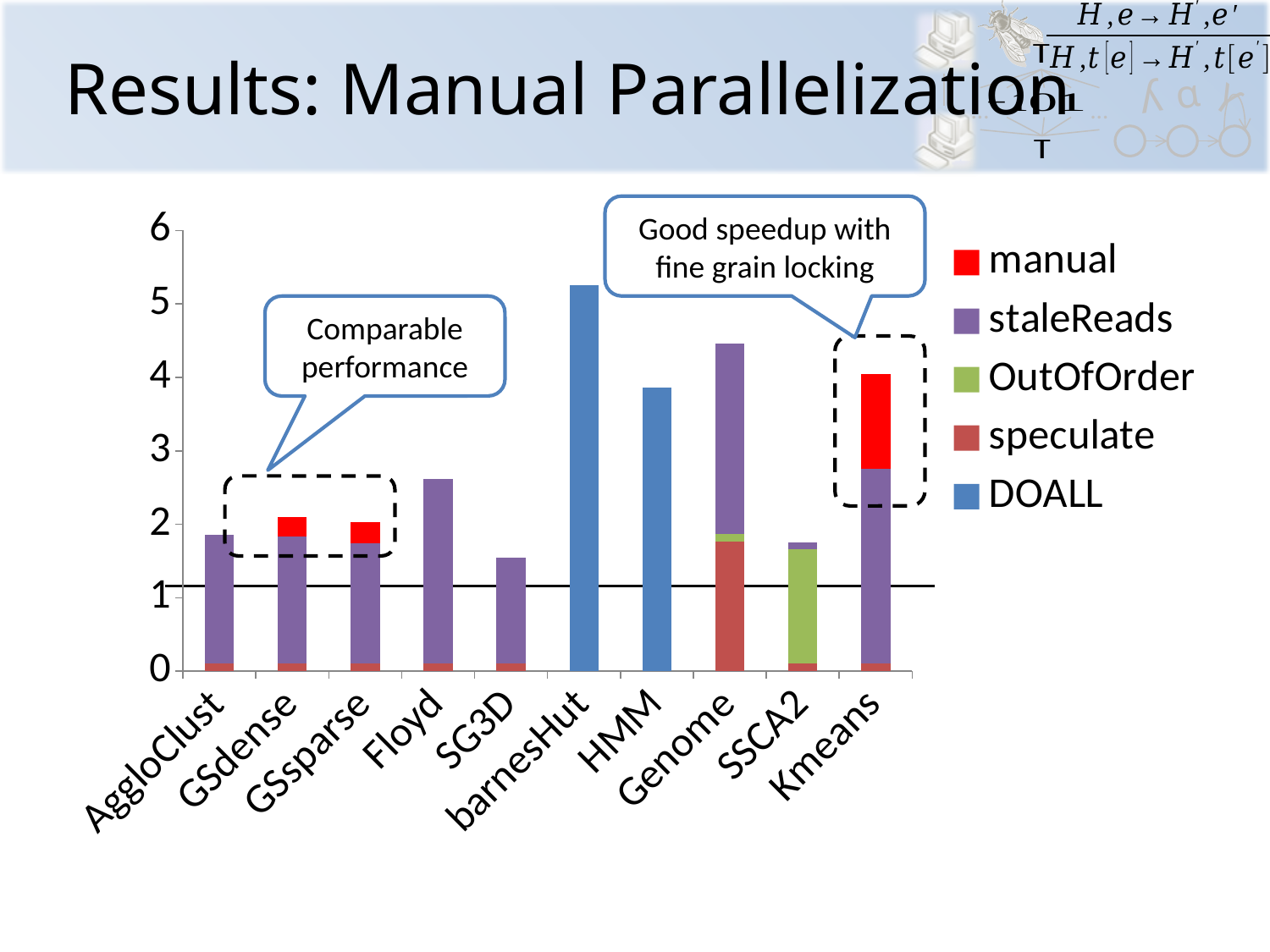
Which bar is taller, barnesHut or HMM? barnesHut Which legend series is shown in red? manual Is the total bar height for barnesHut greater or less than 5? greater What kind of chart is shown on the slide? stacked bar chart Is the total bar height for Genome greater or less than 4? greater Is the total bar height for SG3D greater or less than 2? less Which bar is taller, Genome or Floyd? Genome How many benchmark categories are shown on the x axis? 10 Which benchmark has the shortest bar? SG3D Which benchmark has the tallest bar? barnesHut How many series does the legend list? 5